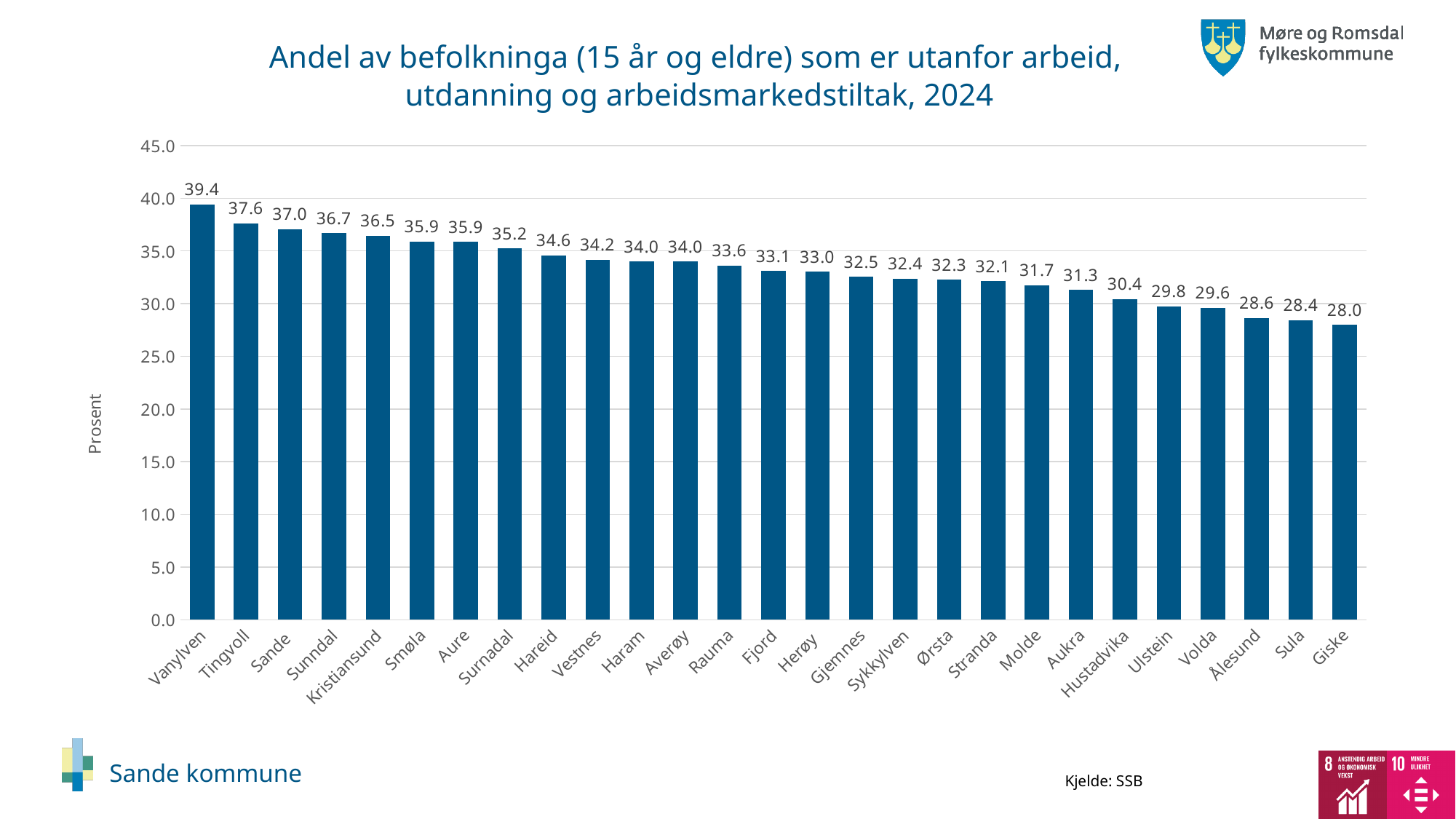
What is the value for Giske? 28.0 What is the value for Molde? 31.7 Which is larger, the value for Hareid or the value for Ulstein? Hareid What is the difference between the values for Vanylven and Giske? 11.4 Do the values rise or fall from left to right along the x axis? fall Which municipality has the lowest value? Giske Is the value for Kristiansund greater or less than 35.0? greater What is the value for Sande? 37.0 How many municipalities are shown on the chart? 27 Which municipality has the highest value? Vanylven What kind of chart is shown on the slide? bar chart What is the difference between the values for Tingvoll and Sande? 0.6